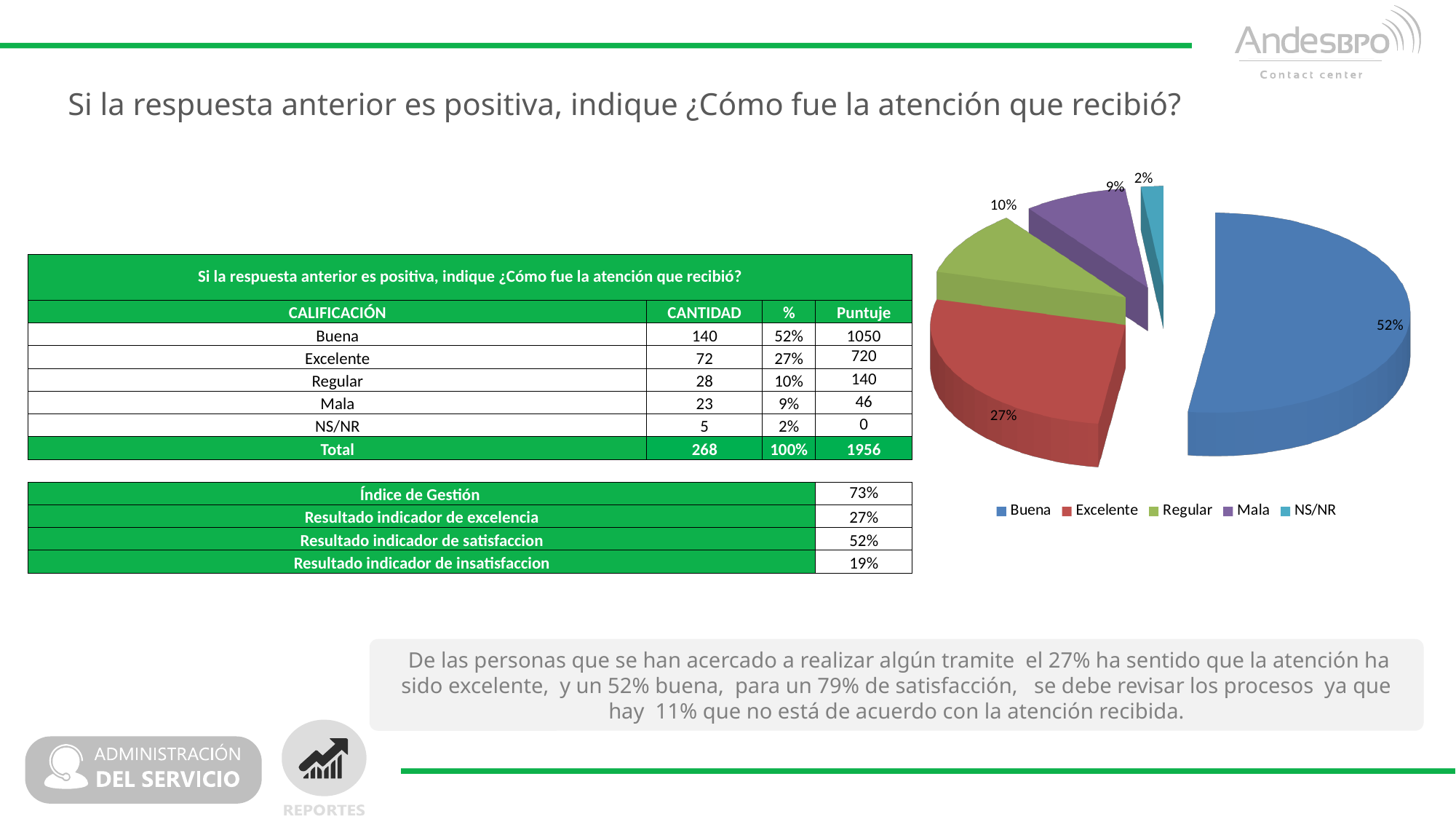
What is the difference in percentage points between the Buena and Excelente slices? 25% What kind of chart is shown on the slide? pie chart Which category has the largest slice of the pie? Buena What colour is the Buena slice in the pie chart? blue What share of the pie does NS/NR represent? 2% What share of the pie does Buena represent? 52% What share of the pie does Mala represent? 9% Which slice is larger, Regular or Mala? Regular How many slices does the pie chart have? 5 Which category has the smallest slice of the pie? NS/NR